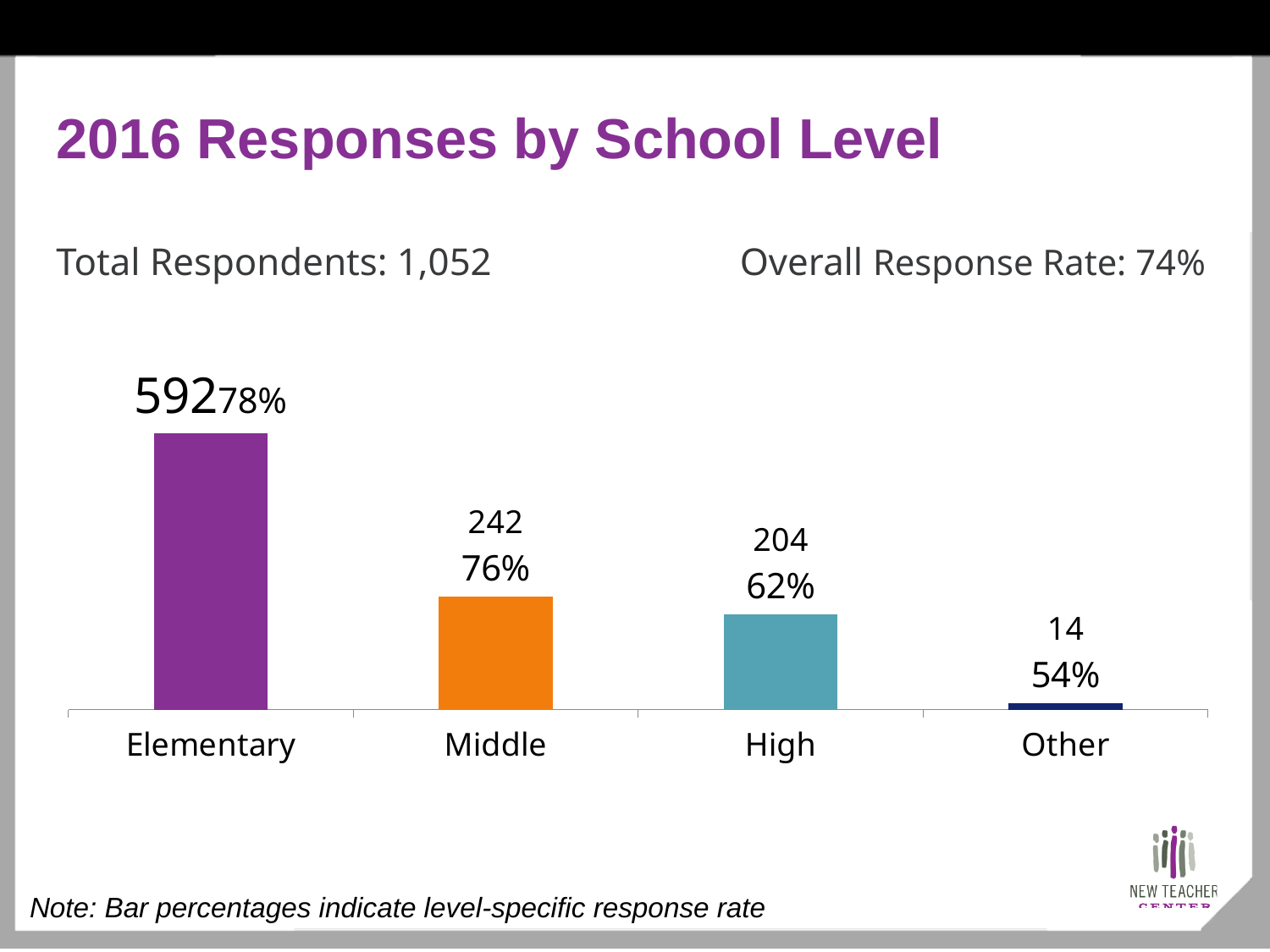
How many school levels are shown on the chart? 4 What is the title of the slide? 2016 Responses by School Level How many respondents are shown for High? 204 Which school level has the highest number of respondents? Elementary What is the response rate shown for Other? 54% How many respondents are shown for Elementary? 592 What kind of chart is shown on the slide? Bar chart What is the response rate shown for Middle? 76% What is the difference in respondents between Middle and High? 38 What is the difference in respondents between Elementary and Middle? 350 Which school level has the lowest number of respondents? Other Which has more respondents, Middle or High? Middle